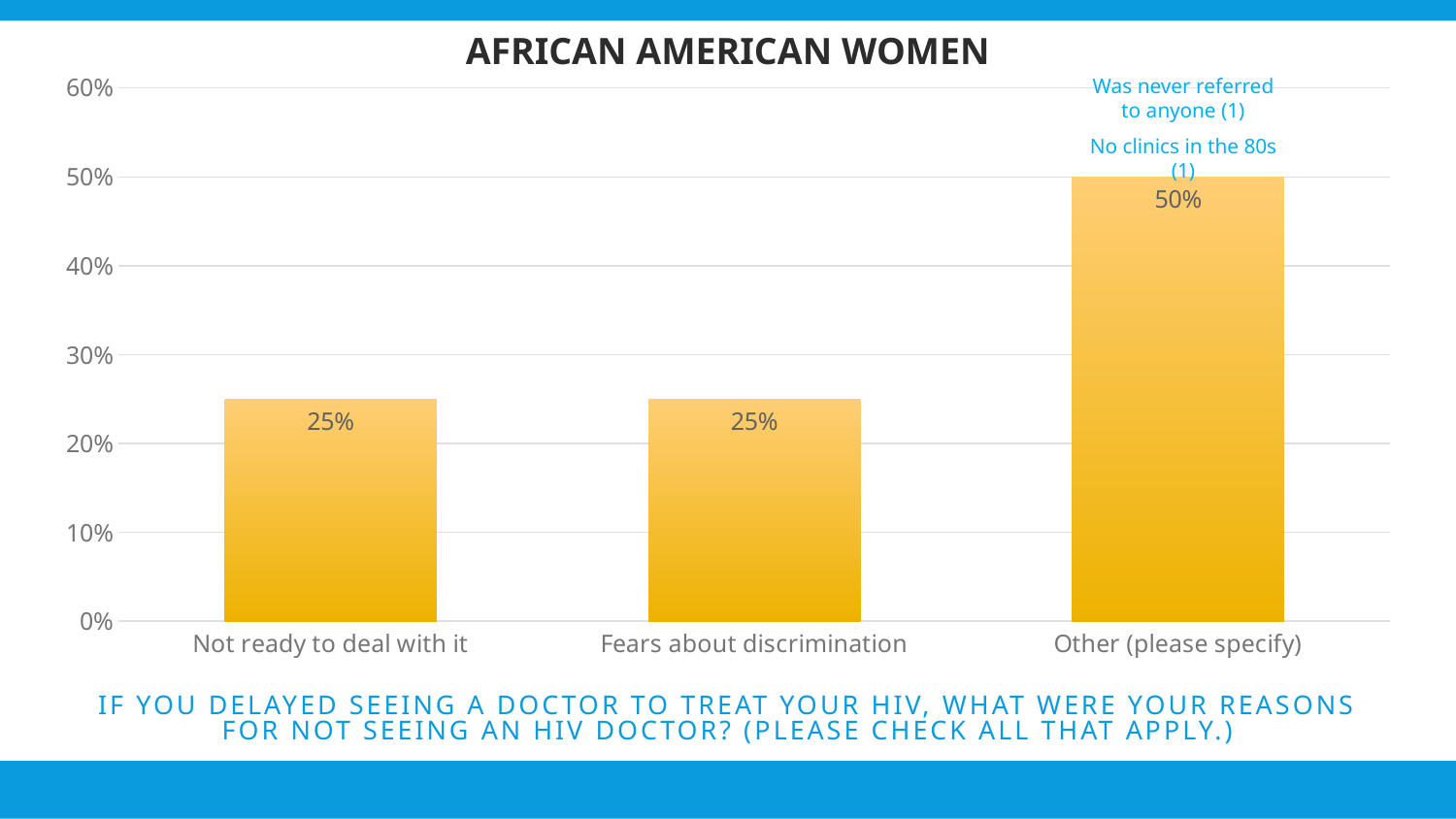
Is the value for "Other (please specify)" greater or less than 40%? greater Which category has the highest value? Other (please specify) Is the value for "Not ready to deal with it" greater or less than 30%? less How many categories are shown on the chart? 3 Which is larger, the value for "Other (please specify)" or the value for "Not ready to deal with it"? Other (please specify) What is the highest value shown on the vertical axis? 60% What is the difference between the values for "Other (please specify)" and "Fears about discrimination"? 25% What is the title of the chart? AFRICAN AMERICAN WOMEN What is the value for "Not ready to deal with it"? 25% What is the value for "Other (please specify)"? 50% What kind of chart is shown on the slide? Bar chart What is the value for "Fears about discrimination"? 25%